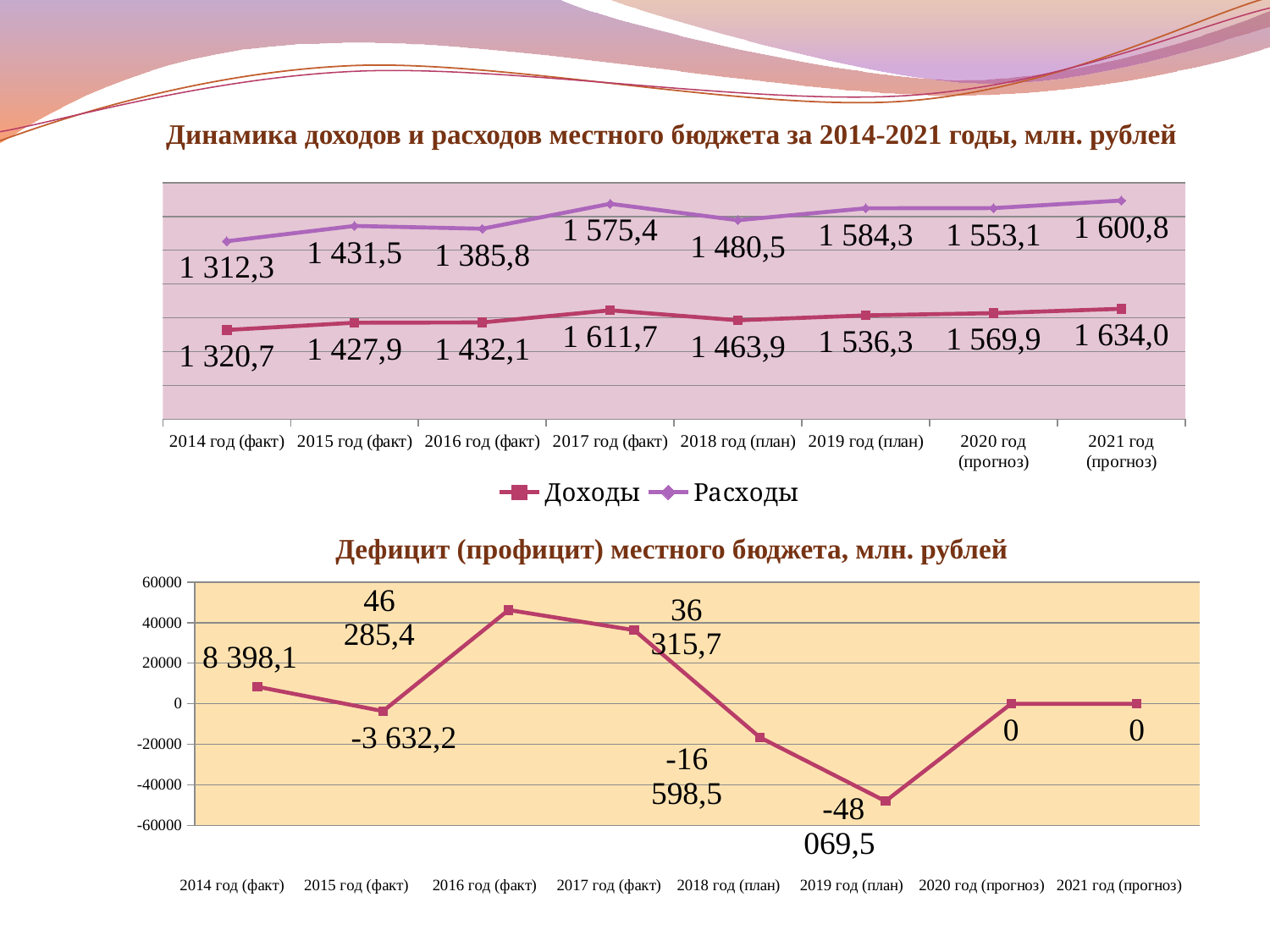
In the top chart 'Динамика доходов и расходов местного бюджета', what is the value of Расходы for 2014 год (факт)? 1 312,3 What kind of chart is the bottom chart 'Дефицит (профицит) местного бюджета'? Line chart In the top chart 'Динамика доходов и расходов местного бюджета', what is the value of Доходы for 2017 год (факт)? 1 611,7 In the top chart 'Динамика доходов и расходов местного бюджета', which year has the lowest value of Расходы? 2014 год (факт) In the top chart 'Динамика доходов и расходов местного бюджета', how many series does the legend list? 2 In the top chart 'Динамика доходов и расходов местного бюджета', what is the value of Расходы for 2021 год (прогноз)? 1 600,8 In the bottom chart 'Дефицит (профицит) местного бюджета', how many years are plotted on the x axis? 8 In the top chart 'Динамика доходов и расходов местного бюджета', which year has the highest value of Доходы? 2021 год (прогноз) In the top chart 'Динамика доходов и расходов местного бюджета', which is larger for 2016 год (факт): Доходы or Расходы? Доходы In the bottom chart 'Дефицит (профицит) местного бюджета', what is the value for 2019 год (план)? -48 069,5 In the bottom chart 'Дефицит (профицит) местного бюджета', which year has the highest value? 2016 год (факт) In the top chart 'Динамика доходов и расходов местного бюджета', what is the difference between Доходы and Расходы for 2019 год (план)? 48,0